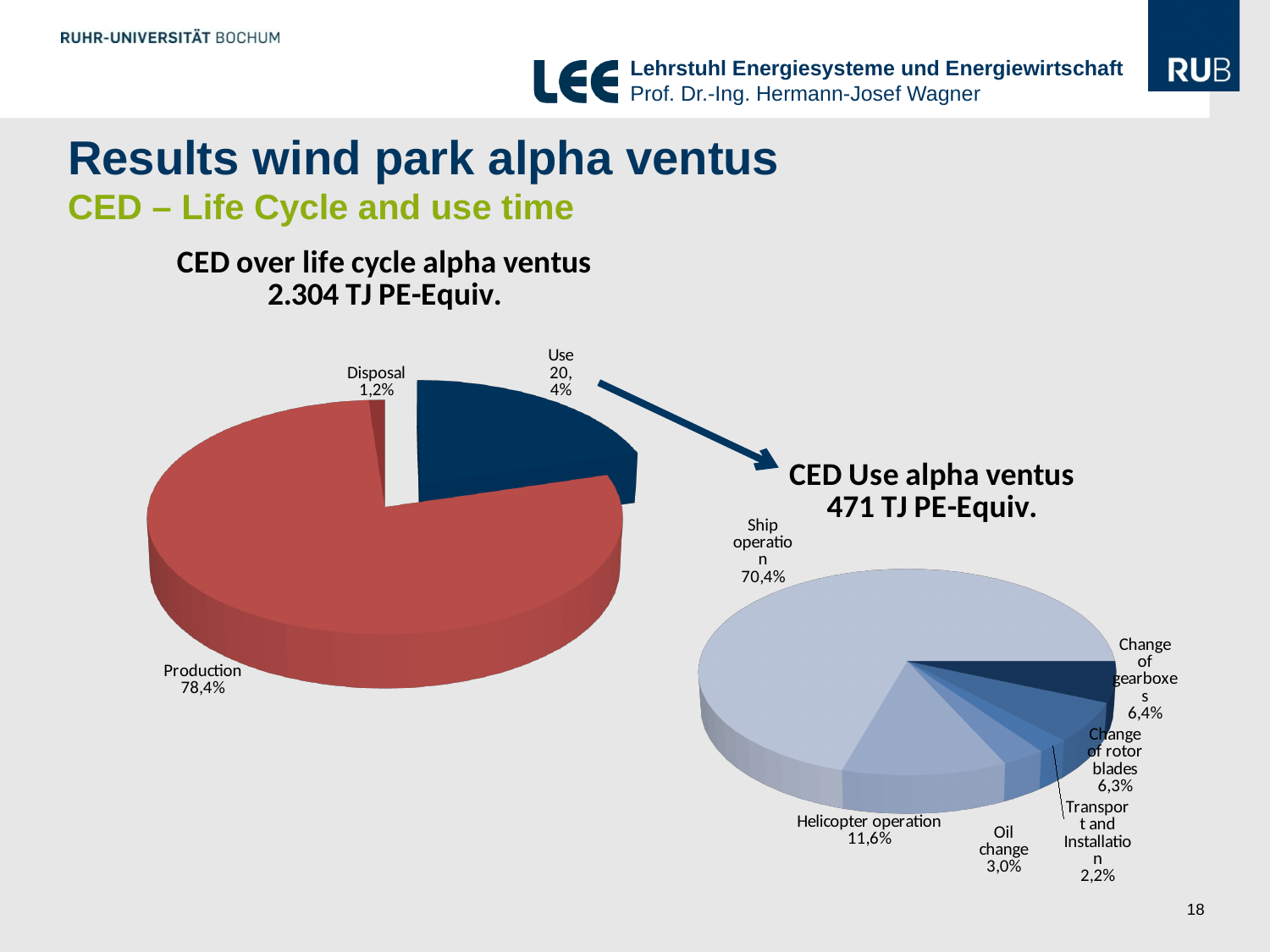
In the 'CED Use alpha ventus' chart, which is larger: Helicopter operation or Oil change? Helicopter operation In the 'CED over life cycle alpha ventus' chart, what share does Production have? 78,4% In the 'CED over life cycle alpha ventus' chart, which category has the largest share? Production In the 'CED Use alpha ventus' chart, how many categories are shown? 6 In the 'CED Use alpha ventus' chart, what share does Helicopter operation have? 11,6% What kind of chart is 'CED Use alpha ventus'? Pie chart In the 'CED Use alpha ventus' chart, what share does Ship operation have? 70,4% In the 'CED over life cycle alpha ventus' chart, which category has the smallest share? Disposal In the 'CED Use alpha ventus' chart, which category has the smallest share? Transport and Installation In the 'CED over life cycle alpha ventus' chart, how many categories are shown? 3